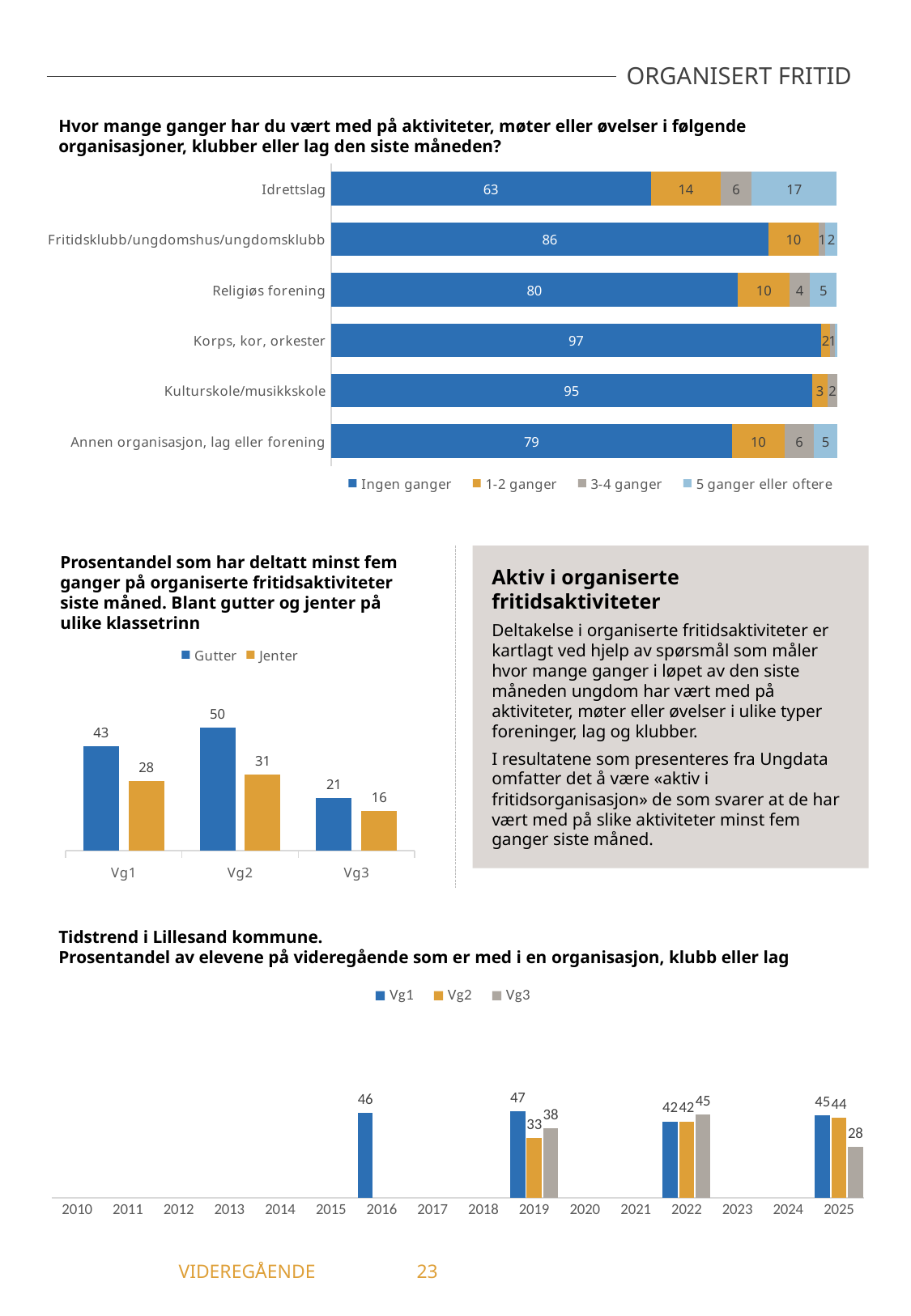
In the top chart (Hvor mange ganger har du vært med på aktiviteter...), what is the value for 'Ingen ganger' for Idrettslag? 63 What kind of chart is the bottom chart (Tidstrend i Lillesand kommune)? Bar chart In the bottom chart, which is larger in 2019: Vg2 or Vg3? Vg3 In the middle chart (Prosentandel som har deltatt minst fem ganger...), what is the value for Jenter at Vg2? 31 In the top chart, which category has the highest value for 'Ingen ganger'? Korps, kor, orkester In the middle chart, which class level has the lowest value for Gutter? Vg3 In the top chart, what is the value for '5 ganger eller oftere' for Idrettslag? 17 In the bottom chart (Tidstrend i Lillesand kommune), what is the value for Vg3 in 2025? 28 In the top chart, how many series does the legend list? 4 In the middle chart, what is the difference between Gutter and Jenter at Vg1? 15 In the top chart, how many categories (organisation types) are shown? 6 In the top chart, what is the difference between the 'Ingen ganger' values for Religiøs forening and Idrettslag? 17